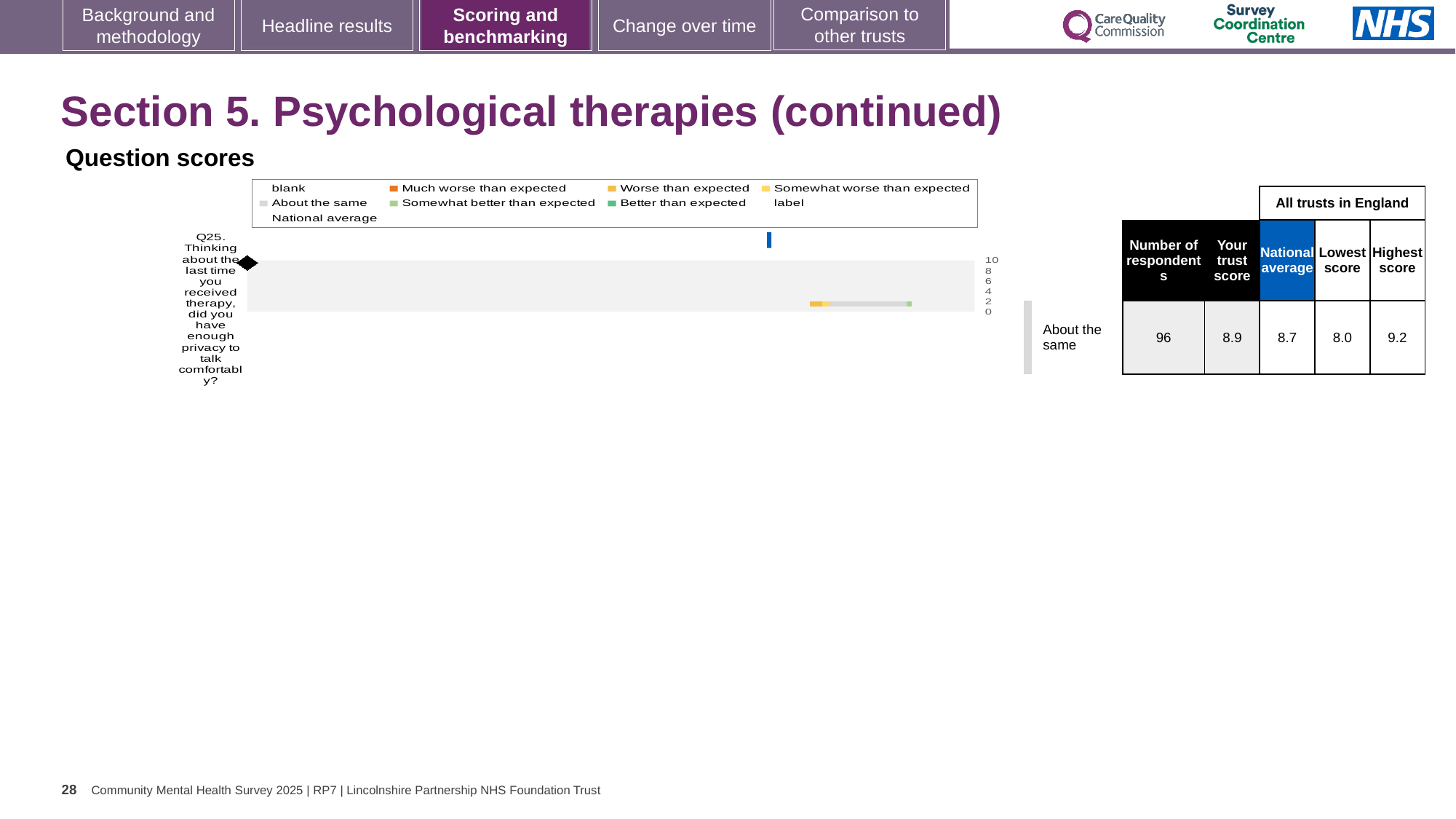
What is the highest value shown on the score axis of the question scores chart? 10 Which is larger for Q25, the trust's score or the national average? the trust's score What benchmark category is the trust's Q25 score placed in, as labelled next to the chart? About the same According to the table beside the chart, what is the national average score for Q25? 8.7 According to the table beside the chart, what is the lowest score among all trusts in England for Q25? 8.0 What is the difference between the highest score and the lowest score among all trusts in England for Q25? 1.2 Which question is plotted in the question scores chart? Q25. Thinking about the last time you received therapy, did you have enough privacy to talk comfortably? According to the table beside the chart, what is the trust's score for Q25? 8.9 According to the table beside the chart, how many respondents answered Q25? 96 How many questions are plotted in the question scores chart? 1 According to the table beside the chart, what is the highest score among all trusts in England for Q25? 9.2 What kind of chart is used to show the question scores on this slide? bar chart